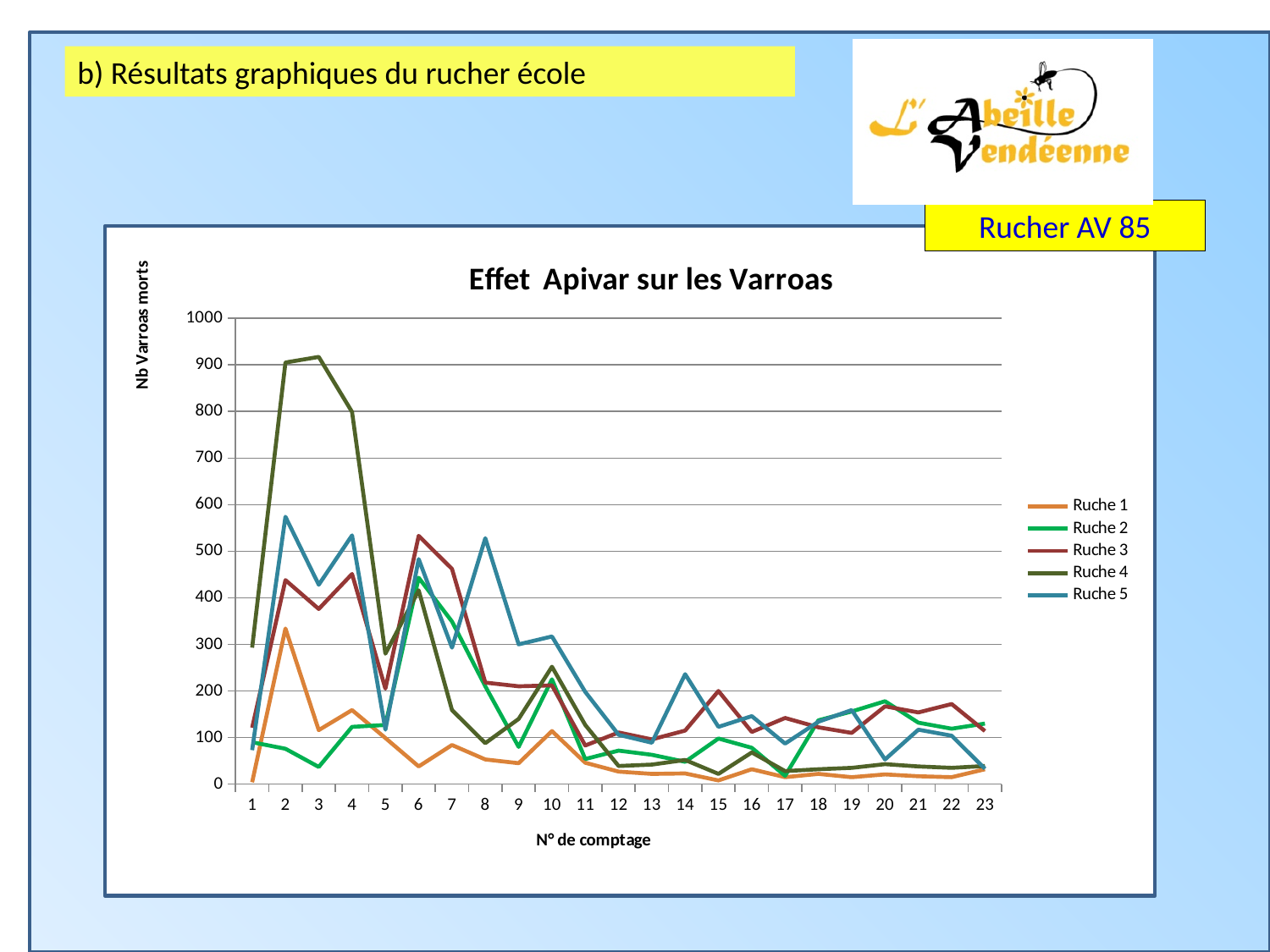
Is the value for Ruche 5 at count 8 greater or less than 400? greater What kind of chart is shown on the slide? line chart Is the value for Ruche 4 at count 3 greater or less than 800? greater Is the value for Ruche 1 at count 17 greater or less than 100? less How many series does the legend list? 5 Which series reaches the highest value on the chart? Ruche 4 At count 2, which is larger: Ruche 4 or Ruche 1? Ruche 4 Does the value for Ruche 4 rise or fall from count 3 to count 5? fall What is the title of the chart? Effet Apivar sur les Varroas What is the label of the vertical axis? Nb Varroas morts How many counting points (N° de comptage) are shown along the x axis? 23